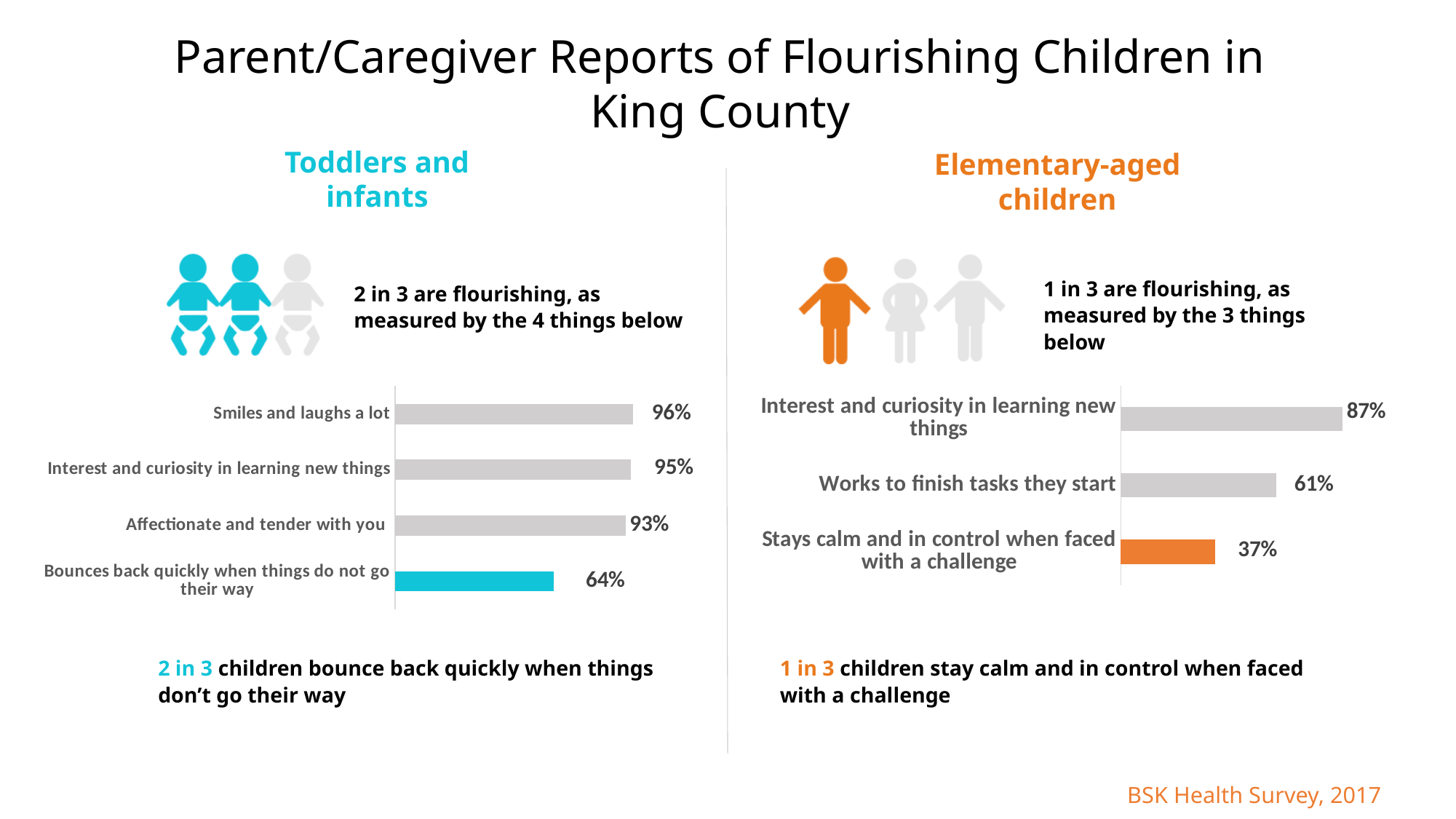
In the Elementary-aged children chart, which category has the highest value? Interest and curiosity in learning new things Which is larger: 'Interest and curiosity in learning new things' in the Toddlers and infants chart or in the Elementary-aged children chart? Toddlers and infants (95%) In the Toddlers and infants chart, what is the value for 'Bounces back quickly when things do not go their way'? 64% In the Elementary-aged children chart, what is the difference between 'Interest and curiosity in learning new things' and 'Stays calm and in control when faced with a challenge'? 50 percentage points In the Elementary-aged children chart, what is the value for 'Works to finish tasks they start'? 61% In the Toddlers and infants chart, which category has the lowest value? Bounces back quickly when things do not go their way How many categories are shown in the Elementary-aged children chart? 3 In the Elementary-aged children chart, what is the value for 'Stays calm and in control when faced with a challenge'? 37% How many categories are shown in the Toddlers and infants chart? 4 In the Toddlers and infants chart, what is the difference between 'Smiles and laughs a lot' and 'Bounces back quickly when things do not go their way'? 32 percentage points What type of chart is used for the Elementary-aged children data? Bar chart In the Toddlers and infants chart, what percentage of children smile and laugh a lot? 96%